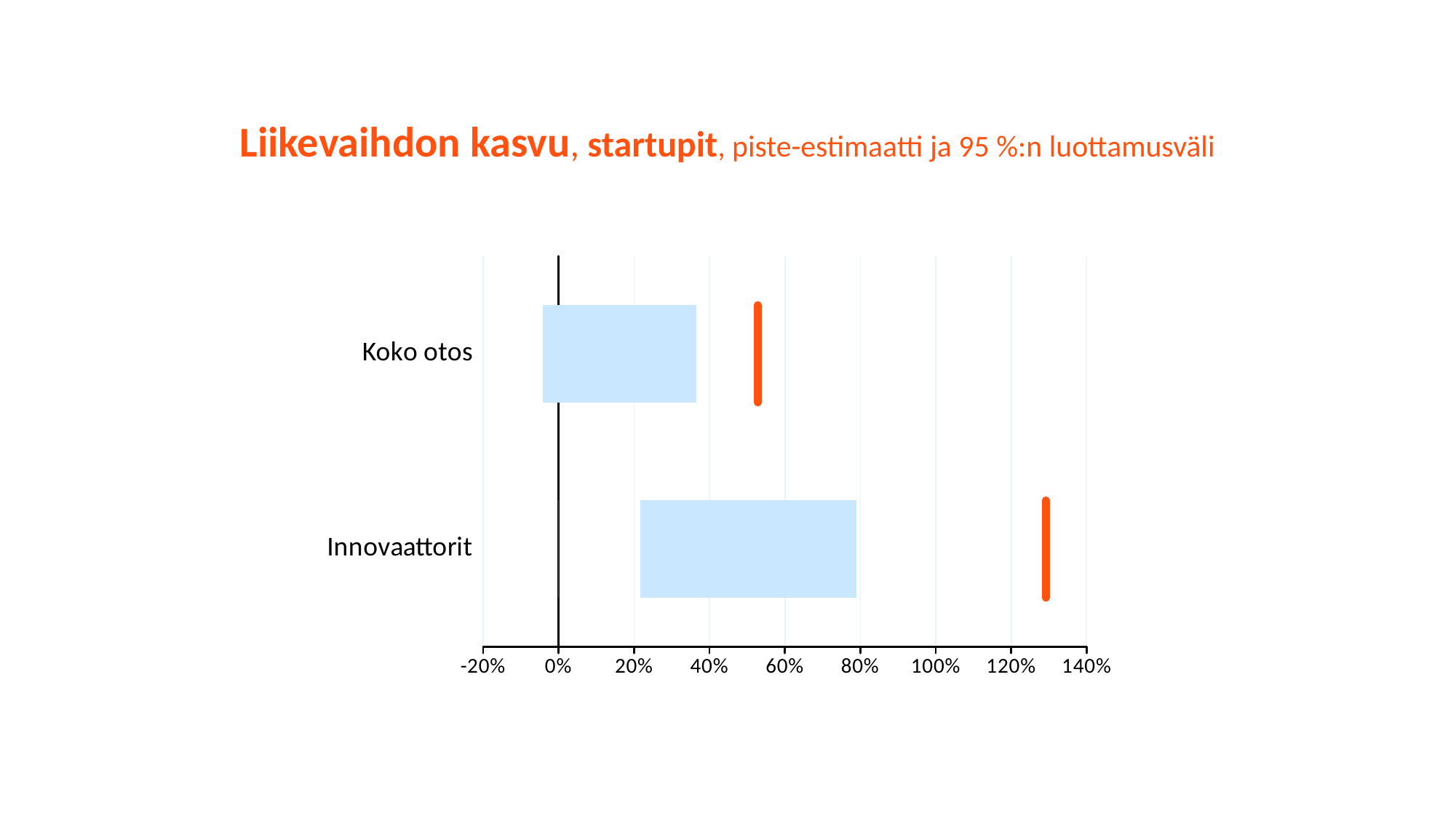
Is the right end of the blue bar for Koko otos greater or less than 40%? less Which category has the longer blue bar, Koko otos or Innovaattorit? Innovaattorit Is the right end of the blue bar for Innovaattorit greater or less than 60%? greater Which category has the highest value on the chart? Innovaattorit Is the orange marker for Koko otos greater or less than 60%? less How many categories are shown on the chart? 2 Which category has the lowest value on the chart? Koko otos What is the title of the chart? Liikevaihdon kasvu, startupit, piste-estimaatti ja 95 %:n luottamusväli What are the minimum and maximum values shown on the horizontal axis? -20% and 140% What kind of chart is shown on the slide? bar chart